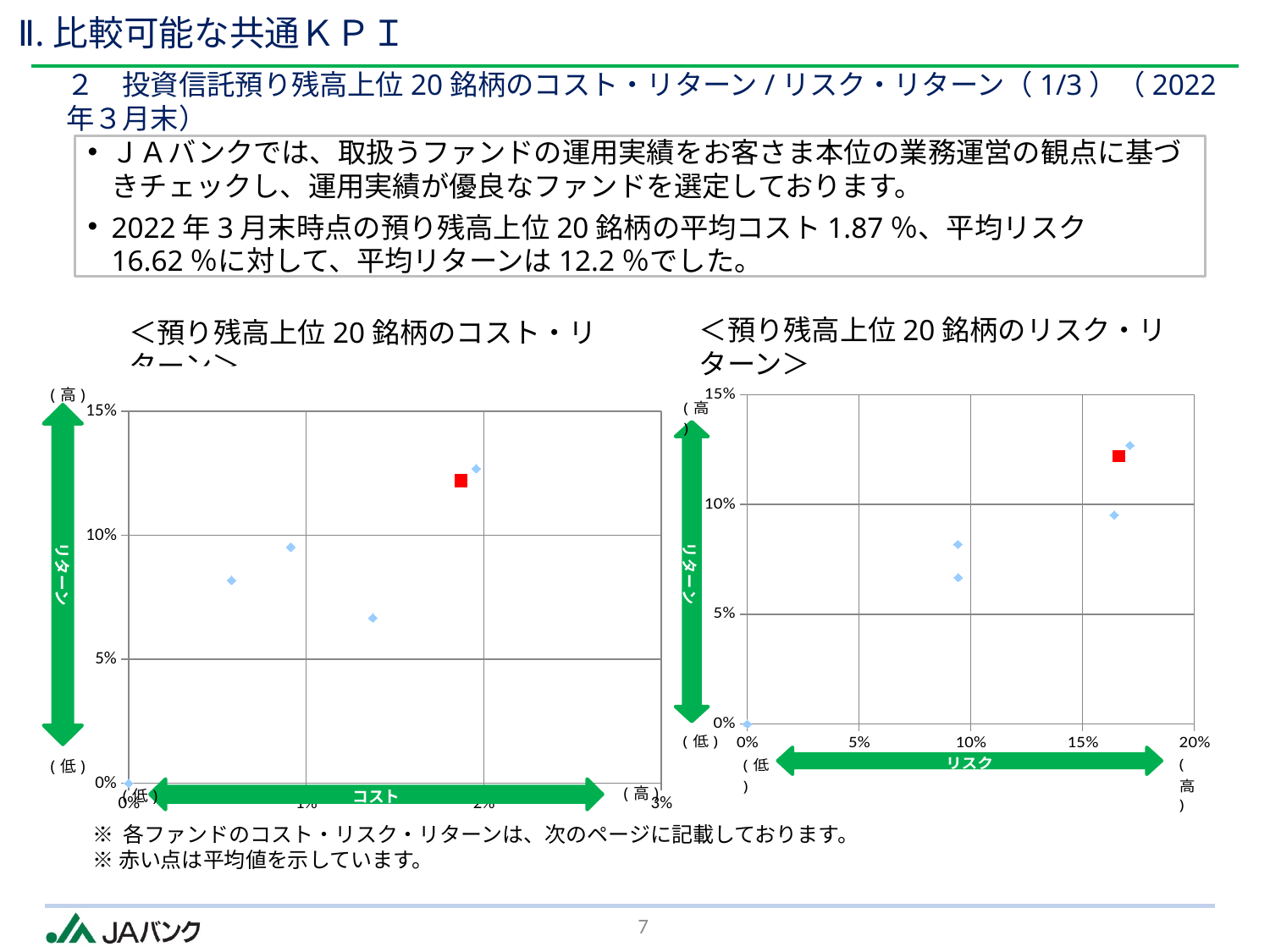
According to the slide, what is the average return of the top 20 funds shown by the red point? 12.2% On the right chart, is the return value of the red point greater or less than 10%? greater On the left chart, is the return value of the red point greater or less than 10%? greater According to the slide, what is the average cost of the top 20 funds shown by the red point on the left chart? 1.87% What does the red point on each chart represent? 平均値 (the average value) What is the label of the horizontal axis on the right chart? リスク According to the slide, what is the average risk of the top 20 funds shown by the red point on the right chart? 16.62% On the left chart, is the cost value of the red point greater or less than 1%? greater What kind of chart is the left chart (預り残高上位20銘柄のコスト・リターン)? scatter chart What kind of chart is the right chart (預り残高上位20銘柄のリスク・リターン)? scatter chart